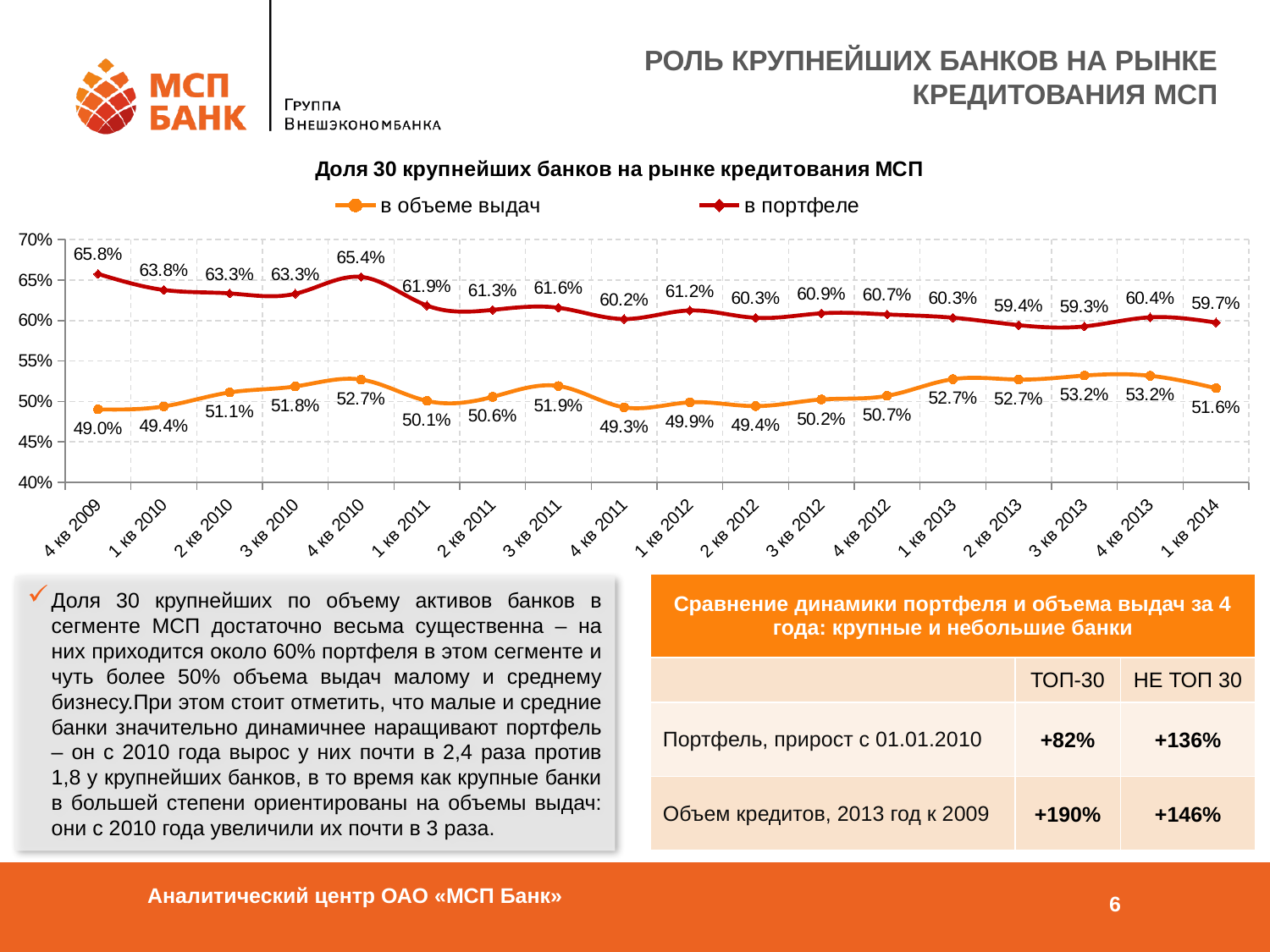
What is the value of the 'в портфеле' series for 3 кв 2013? 59.3% What is the value of the 'в объеме выдач' series for 4 кв 2010? 52.7% How many periods are shown on the x axis of the chart? 18 How many series does the chart legend list? 2 What type of chart is shown on the slide? Line chart Which series has the larger value for 1 кв 2012: 'в портфеле' or 'в объеме выдач'? в портфеле What is the value of the 'в портфеле' series for 4 кв 2009? 65.8% Does the 'в портфеле' series generally rise or fall from 4 кв 2009 to 1 кв 2014? Fall What is the difference between the 'в портфеле' and 'в объеме выдач' values for 4 кв 2009? 16.8 percentage points In which period does the 'в объеме выдач' series have its lowest value? 4 кв 2009 In which period does the 'в портфеле' series reach its highest value? 4 кв 2009 What is the value of the 'в объеме выдач' series for 1 кв 2014? 51.6%